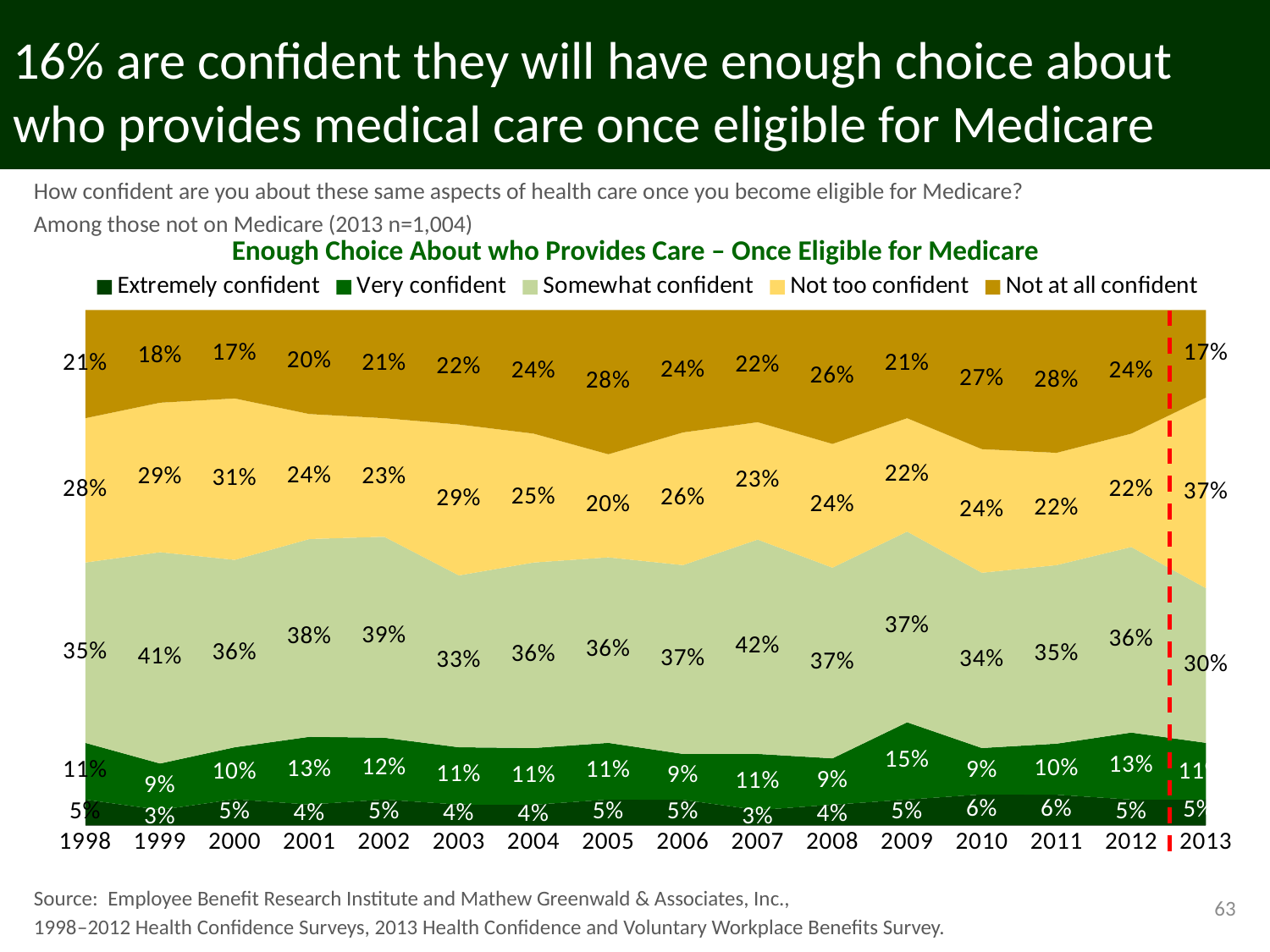
How many series does the legend list? 5 What percentage were "Not too confident" in 2013? 37% How many years are shown on the x axis? 16 What percentage were "Somewhat confident" in 2013? 30% What kind of chart is this? Stacked area chart What percentage were "Not at all confident" in 2005? 28% What is the difference between the "Not too confident" share in 2013 and in 2012? 15 percentage points In which year was the "Very confident" share highest? 2009 What percentage were "Very confident" in 2009? 15% What is the title of the chart? Enough Choice About who Provides Care – Once Eligible for Medicare In which year was the "Somewhat confident" share highest? 2007 Which was larger in 2010: "Not at all confident" or "Not too confident"? Not at all confident